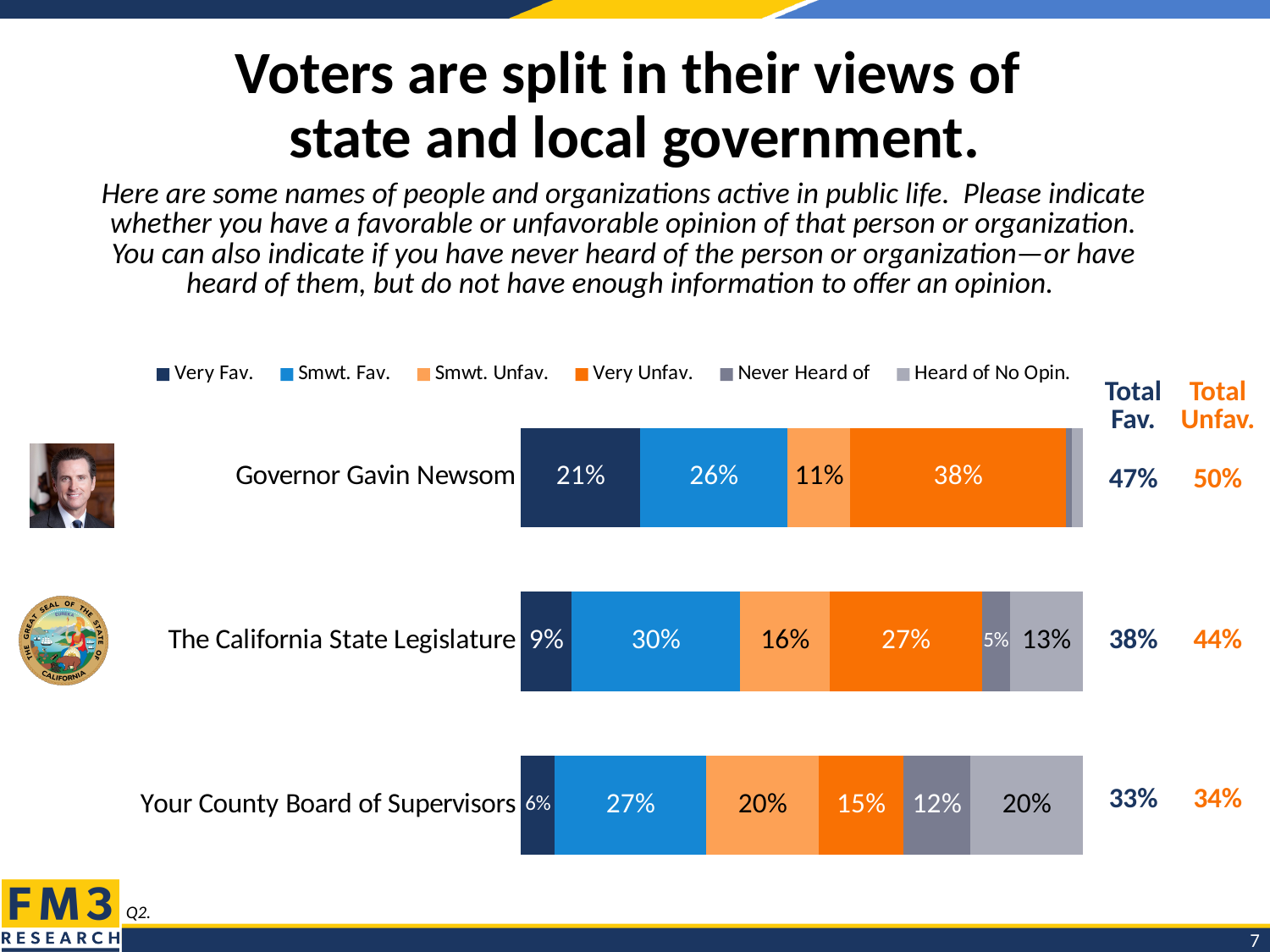
How many percentage points higher is the Smwt. Unfav. value for Your County Board of Supervisors than for Governor Gavin Newsom? 9 percentage points What kind of chart is shown on the slide? Stacked bar chart How many series does the legend list? 6 What share of voters have never heard of Your County Board of Supervisors? 12% How many people or organizations are rated in the chart? 3 What percentage of voters have a very unfavorable opinion of Governor Gavin Newsom? 38% Which has a larger Smwt. Fav. value, Governor Gavin Newsom or Your County Board of Supervisors? Your County Board of Supervisors What do the six labeled segments of The California State Legislature bar add up to? 100% Which of the three has the lowest Very Fav. percentage? Your County Board of Supervisors Which of the three has the highest Very Unfav. percentage? Governor Gavin Newsom What is the Total Fav. figure shown for Governor Gavin Newsom? 47% What is the Smwt. Fav. value for The California State Legislature? 30%